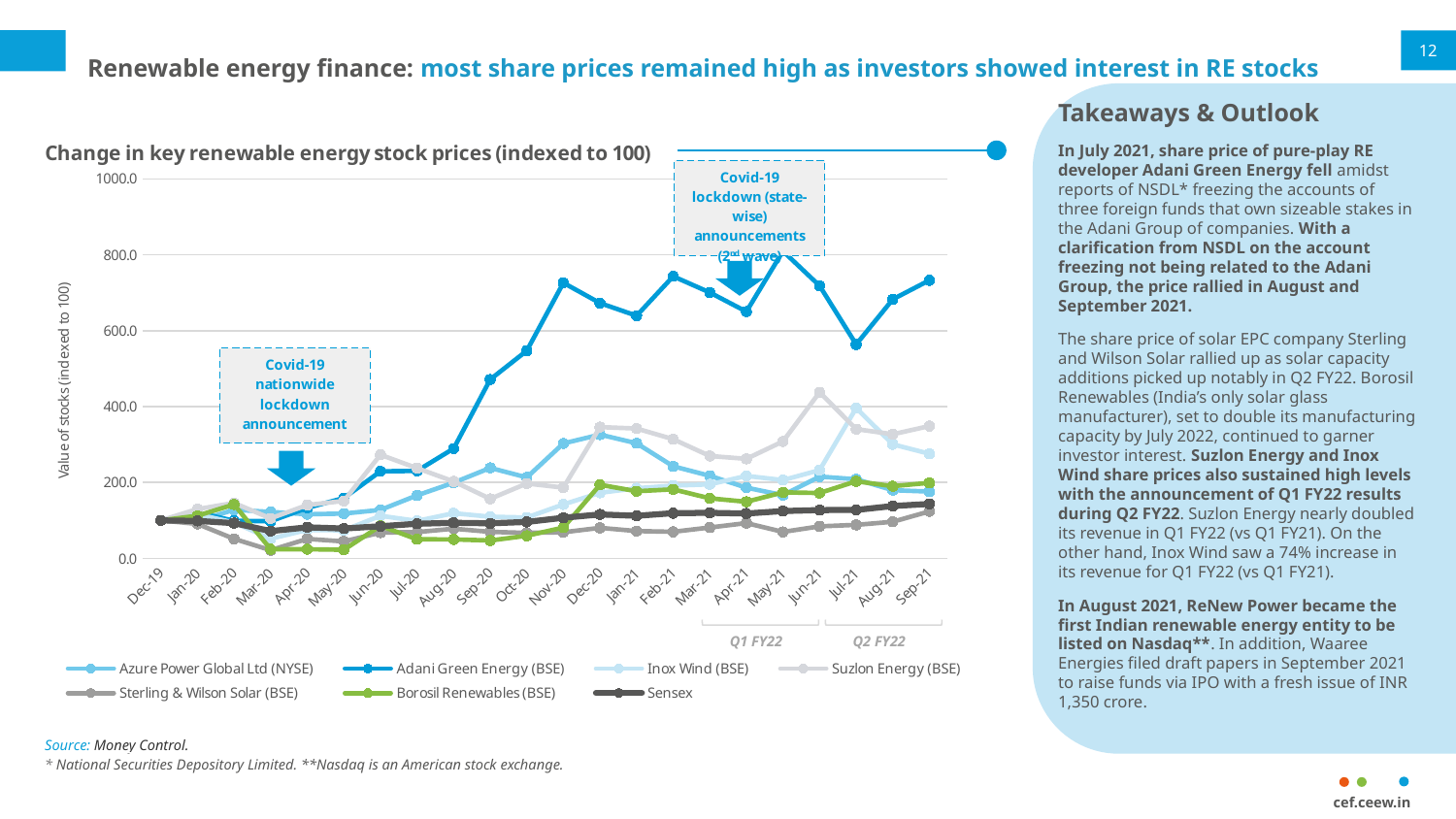
In Sep-21, which is larger: the value for Adani Green Energy (BSE) or the value for Sensex? Adani Green Energy (BSE) Is the value for Adani Green Energy (BSE) in Sep-21 greater or less than 600? greater Is the value for Suzlon Energy (BSE) in Jun-21 greater or less than 200? greater What is the title of the chart? Change in key renewable energy stock prices (indexed to 100) Is the value for Sensex in Sep-21 greater or less than 200? less How many series does the chart legend list? 7 Does the Adani Green Energy (BSE) line rise or fall overall from Dec-19 to Sep-21? Rise Which series reaches the highest value on the chart? Adani Green Energy (BSE) What kind of chart is shown on the slide? Line chart What is the label of the y axis of the chart? Value of stocks (indexed to 100) How many months are shown along the x axis of the chart? 22